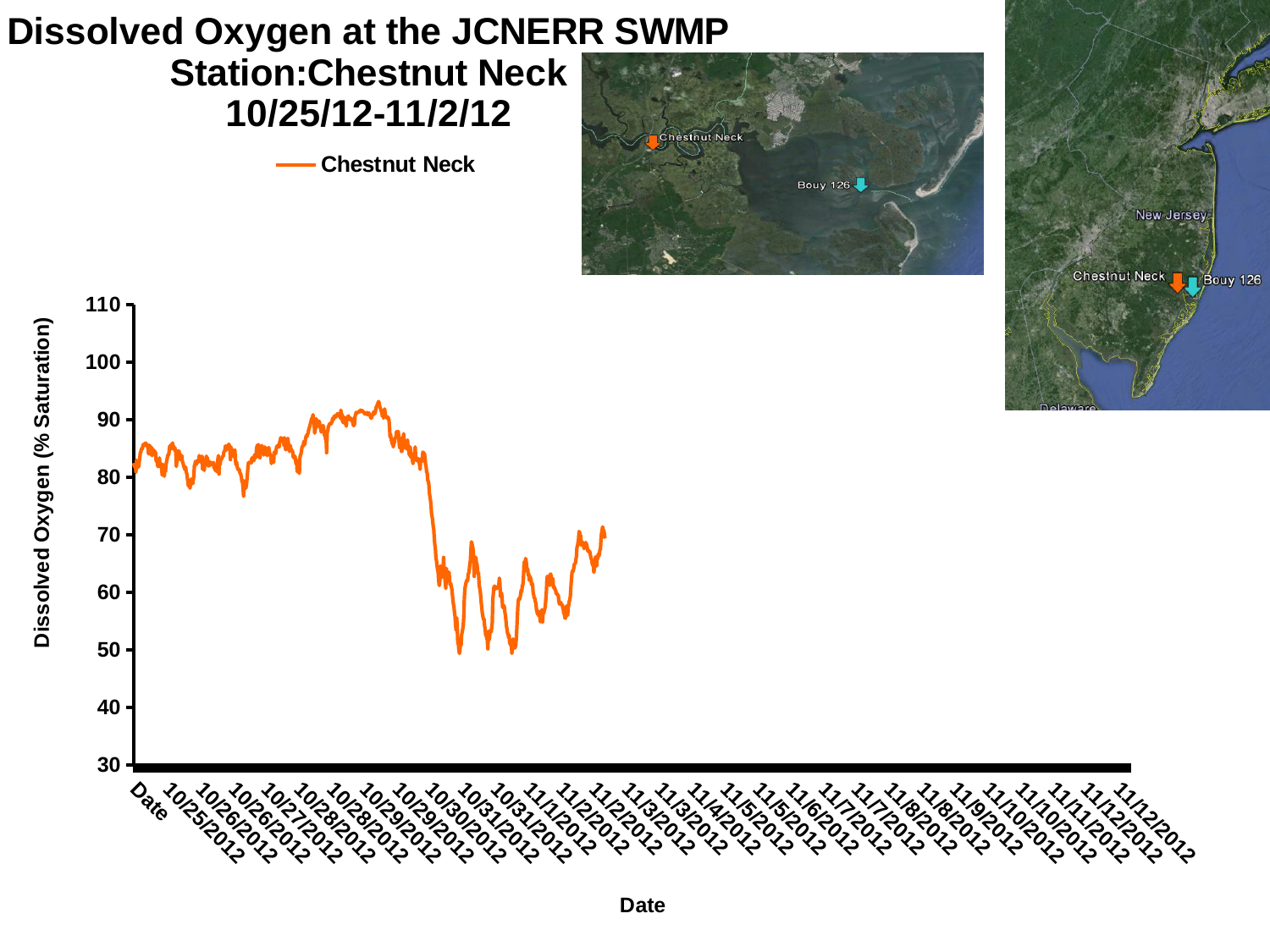
What is the highest value shown on the chart's vertical axis? 110 What kind of chart is shown on the slide? line chart Does the dissolved oxygen value rise or fall between 10/29/2012 and 10/30/2012? fall Is the dissolved oxygen value at the start of the series on 10/25/2012 greater or less than 70? greater How many series does the chart's legend list? 1 Is the dissolved oxygen value on 10/28/2012 higher or lower than the value on 10/31/2012? higher Is the dissolved oxygen value at the end of the series on 11/2/2012 greater or less than 80? less What is the label of the chart's vertical axis? Dissolved Oxygen (% Saturation) Is the dissolved oxygen value around 10/29/2012 greater or less than 80? greater What is the name of the series shown in the chart's legend? Chestnut Neck